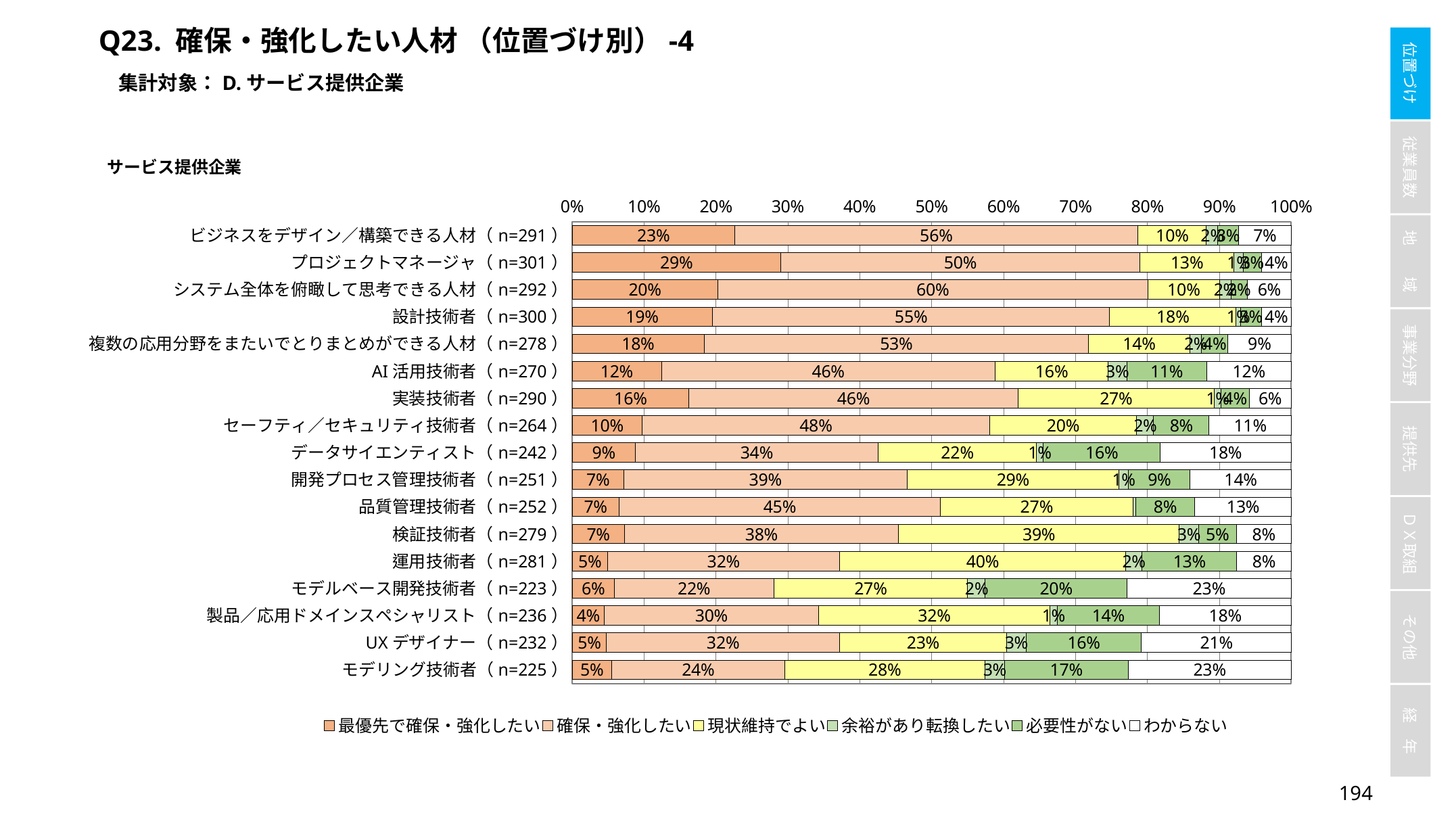
What type of chart is shown on the slide? Stacked bar chart What is the わからない value for AI 活用技術者 (n=270)? 12% Which is larger: the 現状維持でよい value for 検証技術者 (n=279) or for 実装技術者 (n=290)? 検証技術者 (n=279) Which category has the highest 最優先で確保・強化したい value? プロジェクトマネージャ (n=301) What is the difference between the 確保・強化したい values for ビジネスをデザイン／構築できる人材 (n=291) and データサイエンティスト (n=242)? 22% How many series does the legend list? 6 Which category has the lowest 最優先で確保・強化したい value? 製品／応用ドメインスペシャリスト (n=236) What is the 現状維持でよい value for 運用技術者 (n=281)? 40% How many categories (job roles) are plotted on the chart? 17 What is the 最優先で確保・強化したい value for プロジェクトマネージャ (n=301)? 29% What is the 確保・強化したい value for システム全体を俯瞰して思考できる人材 (n=292)? 60% What is the わからない value for モデリング技術者 (n=225)? 23%